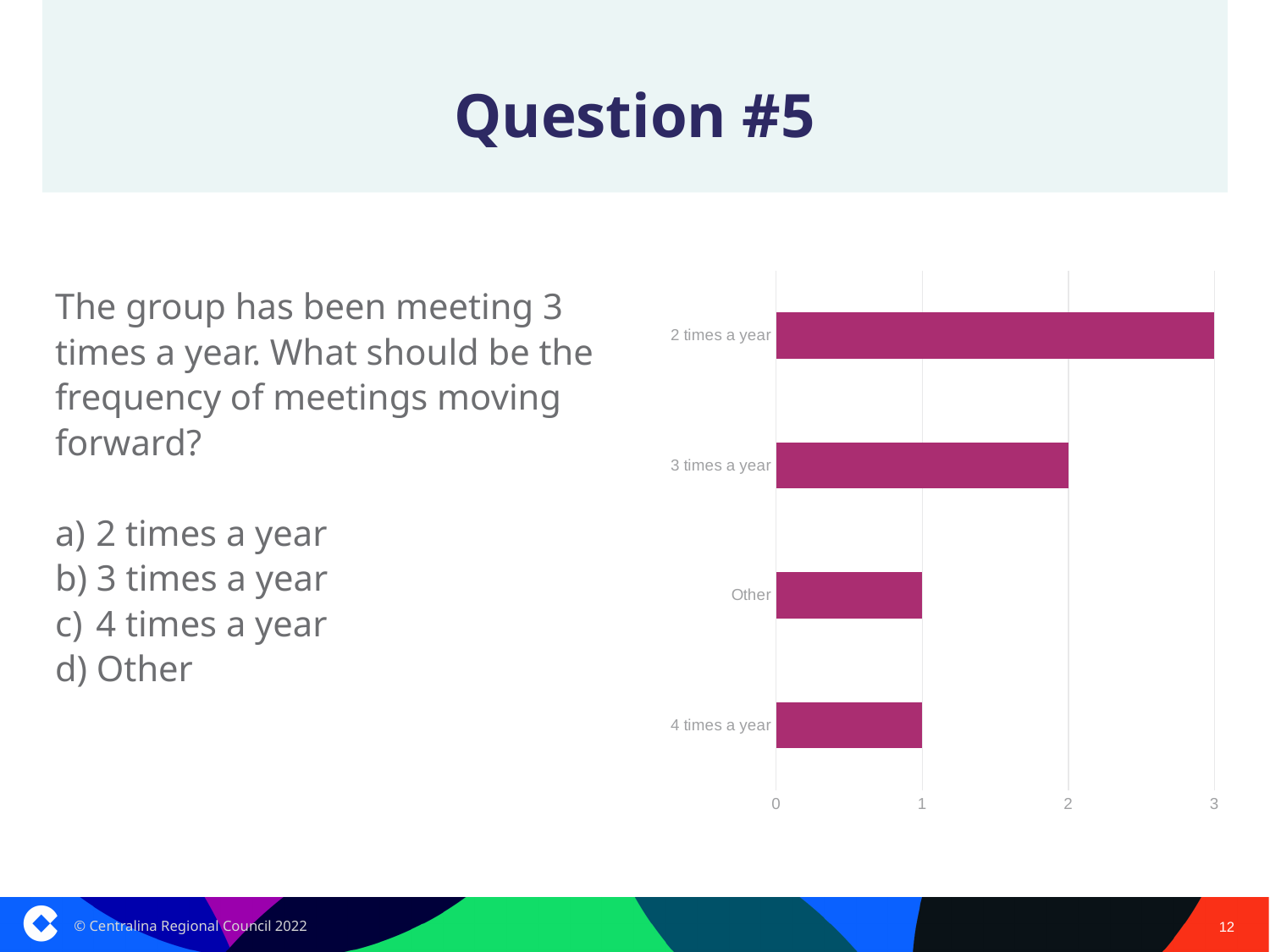
What is the difference between the values for "2 times a year" and "3 times a year"? 1 What is the value for "Other"? 1 What kind of chart is shown on the slide? bar chart What is the highest value shown on the x axis of the chart? 3 How many categories does the bar chart show? 4 What is the value for "4 times a year"? 1 Which category has the highest value? 2 times a year Which is larger, the value for "3 times a year" or the value for "4 times a year"? 3 times a year What is the difference between the values for "2 times a year" and "Other"? 2 What is the value for "3 times a year"? 2 Is the value for "2 times a year" greater or less than 2? greater What is the value for "2 times a year"? 3